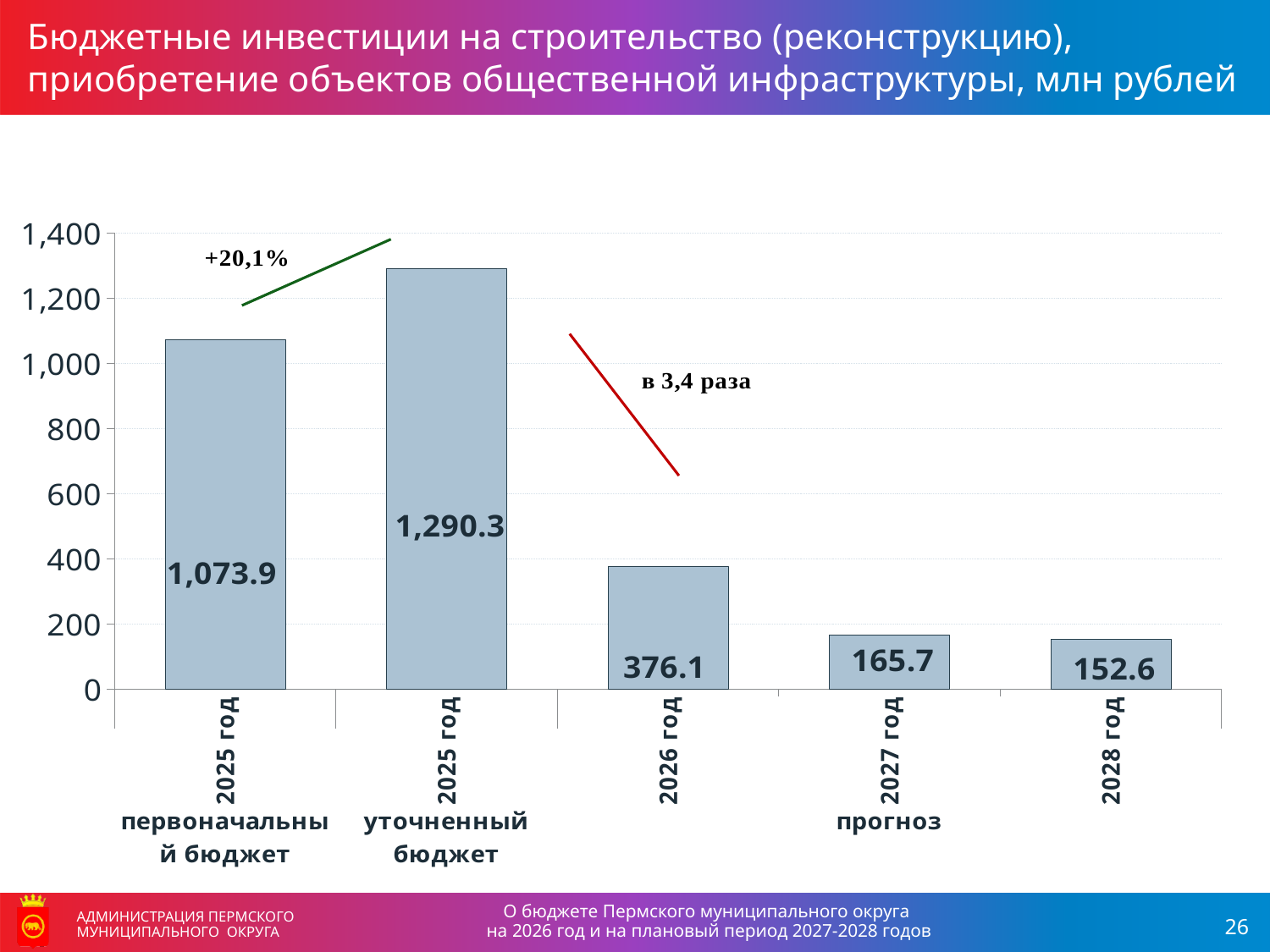
Which is larger, the value for 2026 год or the value for 2027 год? 2026 год What is the value for 2025 год (уточненный бюджет)? 1,290.3 What is the value for 2025 год (первоначальный бюджет)? 1,073.9 What is the value for 2028 год? 152.6 What is the value for 2026 год? 376.1 What percentage change is annotated between the two 2025 bars? +20,1% What kind of chart is shown on the slide? Bar chart Which category has the lowest value? 2028 год What is the difference between the values for 2027 год and 2028 год? 13.1 How many bars are shown in the chart? 5 What is the difference between the 2025 уточненный бюджет value and the 2025 первоначальный бюджет value? 216.4 Which category has the highest value? 2025 год (уточненный бюджет)